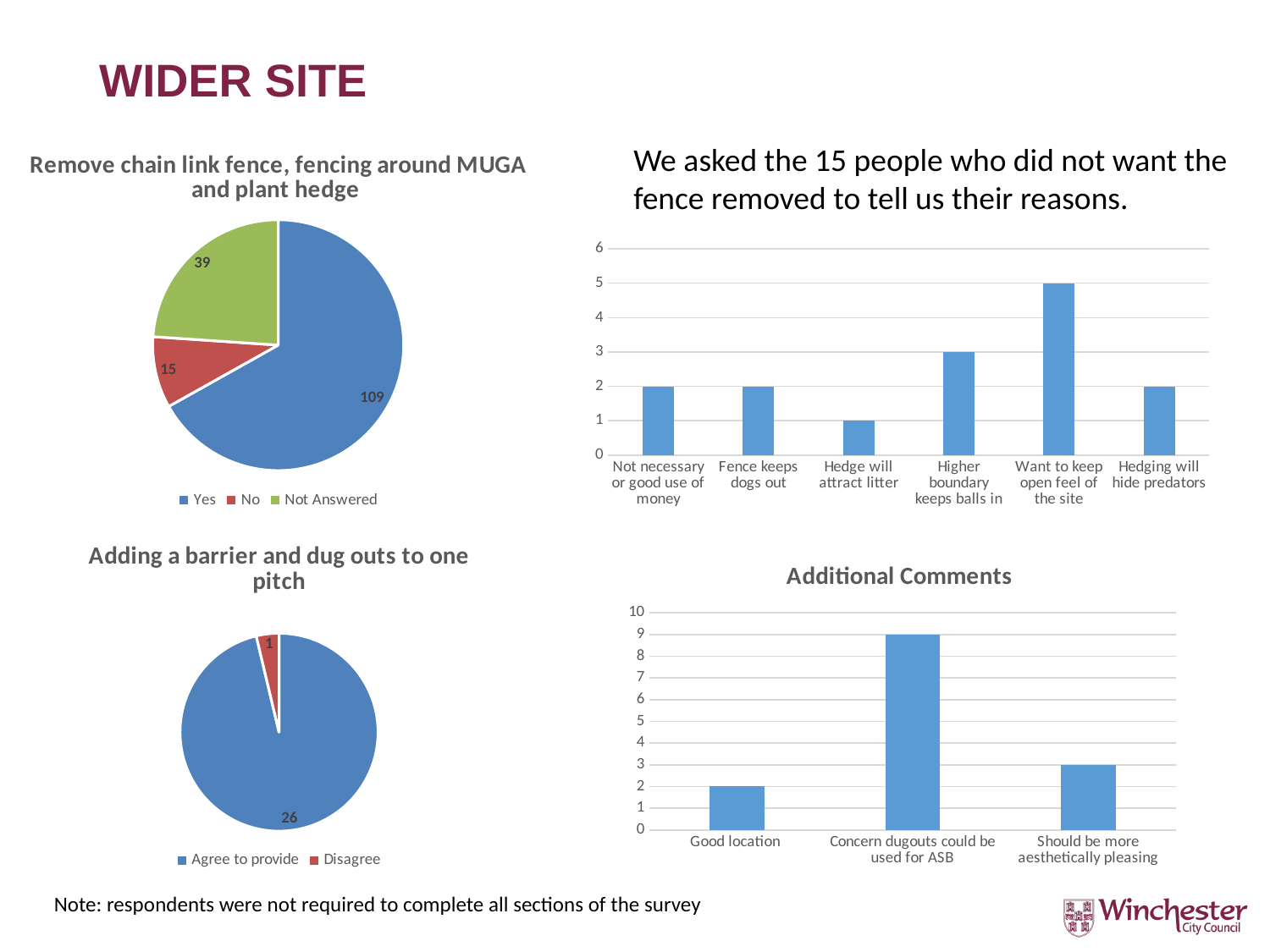
What kind of chart is the 'Additional Comments' chart? Bar chart In the top-right bar chart showing reasons for not wanting the fence removed, which reason has the lowest value? Hedge will attract litter In the top-right bar chart showing reasons for not wanting the fence removed, which reason has the highest value? Want to keep open feel of the site In the 'Adding a barrier and dug outs to one pitch' pie chart, what is the value for Agree to provide? 26 In the 'Additional Comments' chart, what is the value for 'Concern dugouts could be used for ASB'? 9 In the 'Remove chain link fence, fencing around MUGA and plant hedge' pie chart, what is the difference between the Yes and No values? 94 In the top-right bar chart showing reasons for not wanting the fence removed, what is the value for 'Higher boundary keeps balls in'? 3 In the 'Remove chain link fence, fencing around MUGA and plant hedge' pie chart, what is the value for Not Answered? 39 How many categories are shown in the top-right bar chart showing reasons for not wanting the fence removed? 6 In the 'Remove chain link fence, fencing around MUGA and plant hedge' pie chart, what is the value for Yes? 109 In the 'Adding a barrier and dug outs to one pitch' pie chart, which is larger, Agree to provide or Disagree? Agree to provide How many entries does the legend of the 'Remove chain link fence, fencing around MUGA and plant hedge' pie chart list? 3